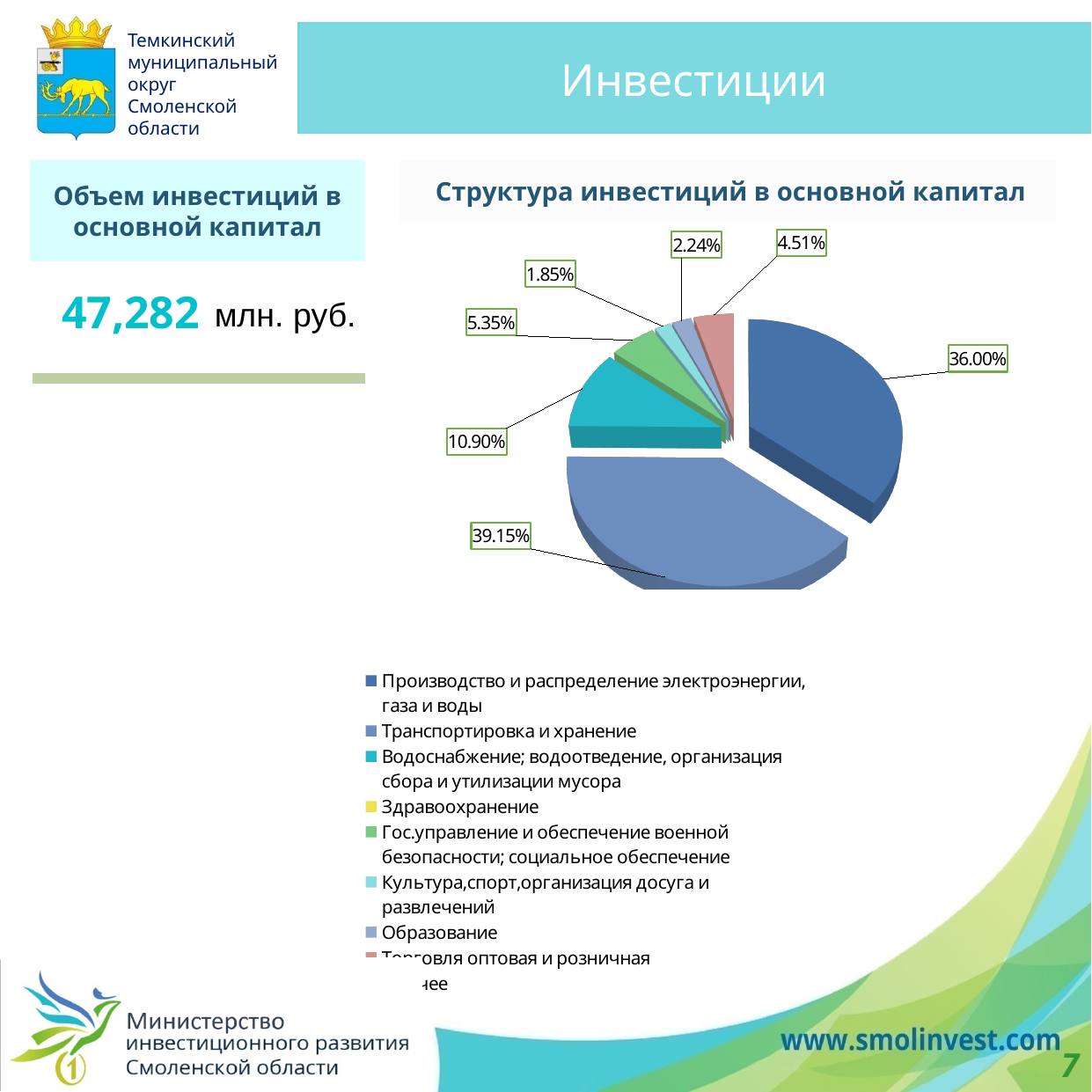
What is the title of the pie chart on the slide? Структура инвестиций в основной капитал In the pie chart, what is the difference in percentage points between the 10.90% slice and the 5.35% slice? 5.55 What share does 'Производство и распределение электроэнергии, газа и воды' have in the pie chart? 36.00% In the pie chart, which has the larger share: 'Торговля оптовая и розничная' or 'Образование'? Торговля оптовая и розничная What kind of chart is used to show the structure of investments in fixed capital (Структура инвестиций в основной капитал)? pie chart In the pie chart, what is the difference in percentage points between the 39.15% slice and the 36.00% slice? 3.15 What is the largest share shown in the pie chart 'Структура инвестиций в основной капитал'? 39.15% Which category has the largest share in the pie chart 'Структура инвестиций в основной капитал'? Транспортировка и хранение What share does 'Гос.управление и обеспечение военной безопасности; социальное обеспечение' have in the pie chart? 5.35% How many slices with percentage labels are shown in the pie chart 'Структура инвестиций в основной капитал'? 7 Which category has the smallest labeled share in the pie chart 'Структура инвестиций в основной капитал'? Культура,спорт,организация досуга и развлечений What share does 'Водоснабжение; водоотведение, организация сбора и утилизации мусора' have in the pie chart? 10.90%